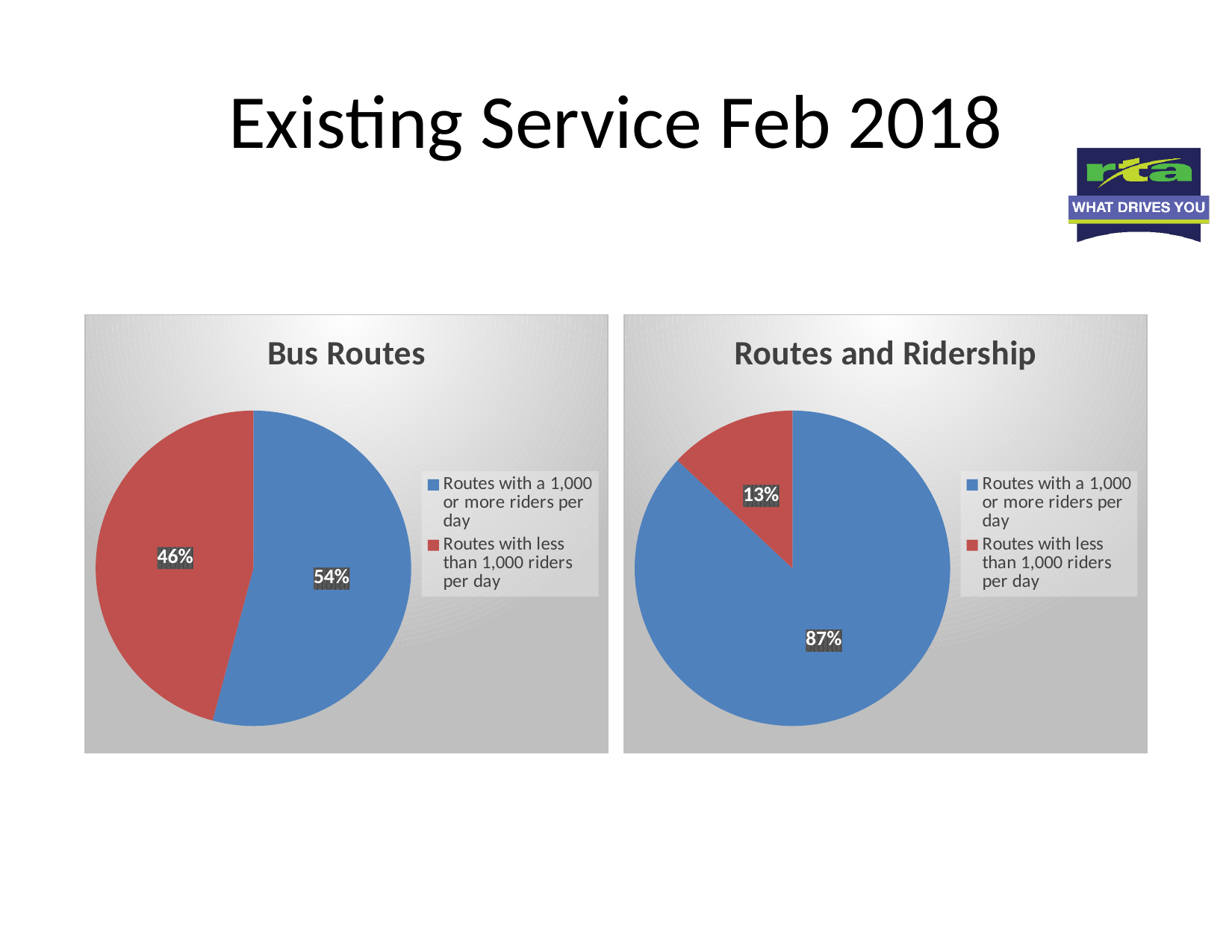
What kind of chart is the Bus Routes chart? Pie chart In the Routes and Ridership chart, what share of the pie is for routes with a 1,000 or more riders per day? 87% In the Bus Routes chart, what is the difference between the two slices' percentages? 8% In the Bus Routes chart, what share of the pie is for routes with a 1,000 or more riders per day? 54% In the Routes and Ridership chart, what is the difference between the two slices' percentages? 74% In the Routes and Ridership chart, what share of the pie is for routes with less than 1,000 riders per day? 13% In the Bus Routes chart, what colour is the slice for routes with less than 1,000 riders per day? Red In the Routes and Ridership chart, which is larger: the slice for routes with a 1,000 or more riders per day or the slice for routes with less than 1,000 riders per day? Routes with a 1,000 or more riders per day How many slices does the Routes and Ridership chart have? 2 In the Routes and Ridership chart, which slice is the smallest? Routes with less than 1,000 riders per day In the Bus Routes chart, which slice is the largest? Routes with a 1,000 or more riders per day